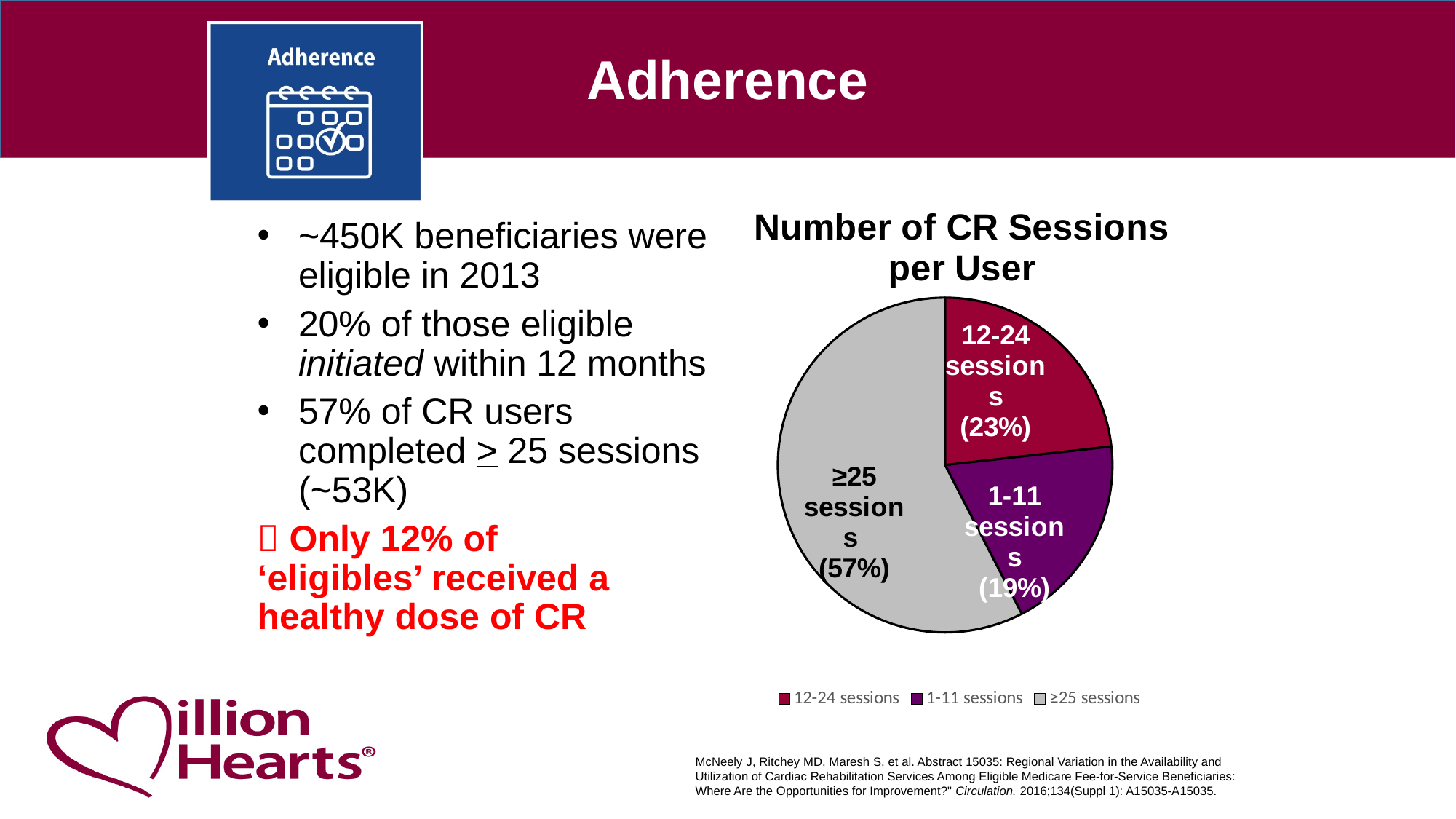
Which category has the smallest slice of the pie? 1-11 sessions How many slices does the pie chart have? 3 What kind of chart is shown on the slide? Pie chart What is the difference in percentage points between the ≥25 sessions slice and the 12-24 sessions slice? 34 What colour is the ≥25 sessions slice? Grey What share of CR users completed ≥25 sessions? 57% What share of CR users completed 12-24 sessions? 23% What share of CR users completed 1-11 sessions? 19% How many entries does the legend list? 3 Which category has the largest slice of the pie? ≥25 sessions What is the title of the chart? Number of CR Sessions per User Which slice is larger: 12-24 sessions or 1-11 sessions? 12-24 sessions